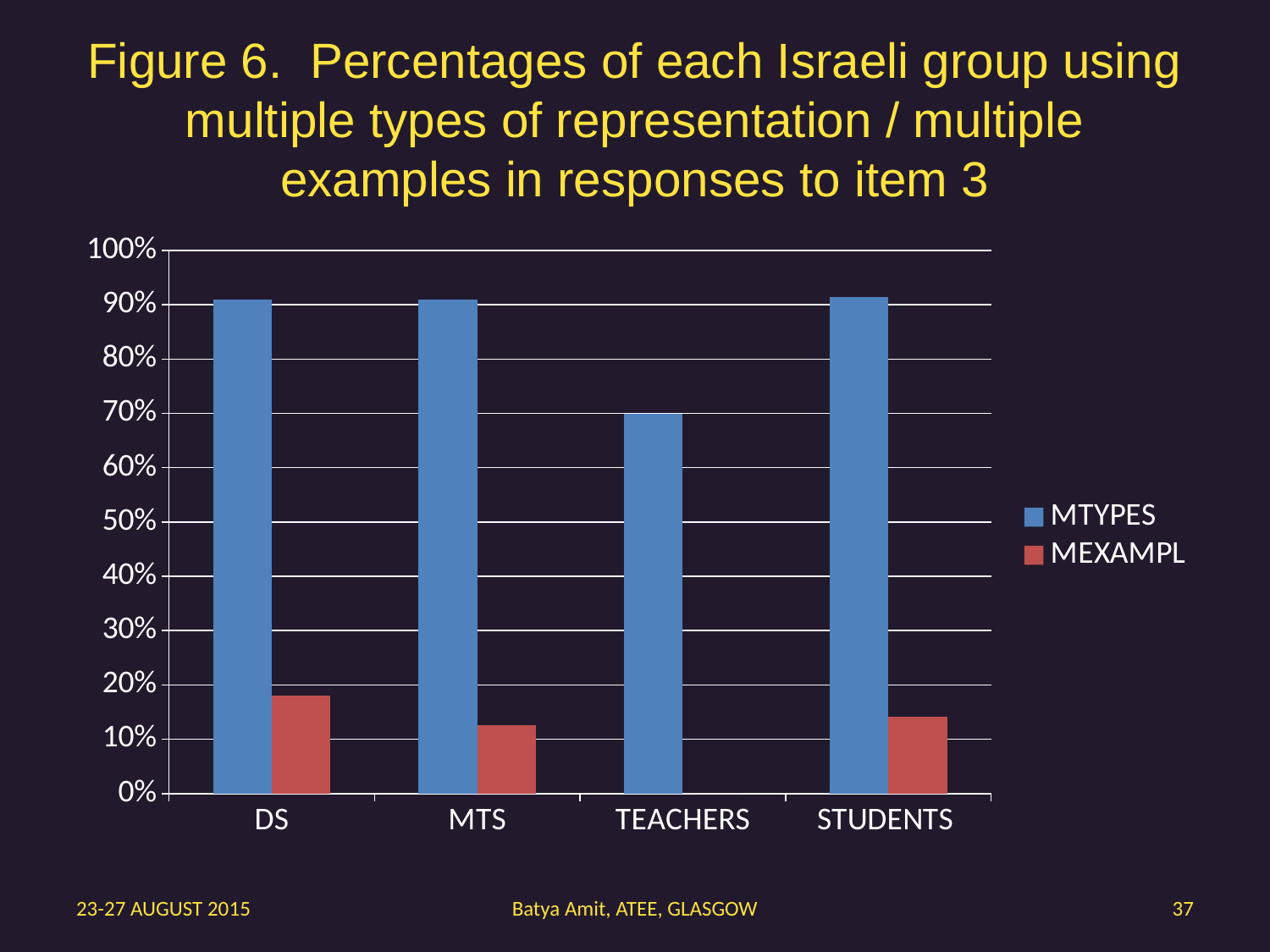
Which is larger for TEACHERS, the MTYPES value or the MEXAMPL value? MTYPES Which group has the lowest MTYPES value? TEACHERS How many groups are shown on the x axis of the chart? 4 What is the MTYPES value for TEACHERS? 70% Is the MEXAMPL value for STUDENTS greater or less than 20%? less What colour are the MEXAMPL bars in the chart? red Is the MEXAMPL value for DS greater or less than 20%? less Which is larger, the MEXAMPL value for DS or the MEXAMPL value for MTS? DS Is the MTYPES value for DS greater or less than 80%? greater Which group has the highest MEXAMPL value? DS How many series does the legend list? 2 What type of chart is shown on the slide? bar chart